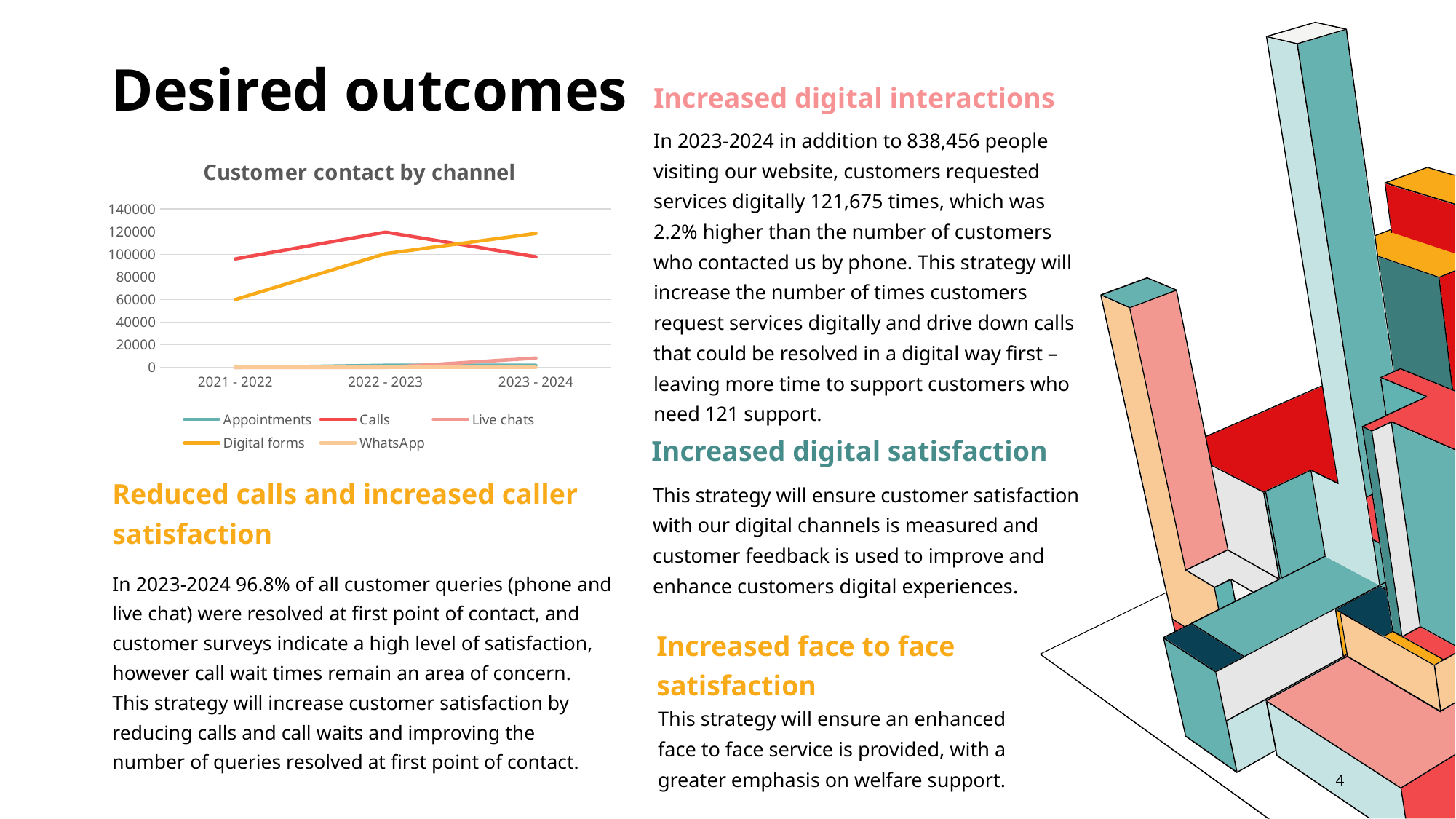
Is the value for Calls in 2023 - 2024 greater or less than 80000? greater What is the title of the chart? Customer contact by channel In 2023 - 2024, which is larger: Digital forms or Calls? Digital forms Is the value for Digital forms in 2021 - 2022 greater or less than 80000? less Which series has the highest value in 2022 - 2023? Calls In 2021 - 2022, which is larger: Calls or Digital forms? Calls In which period does the Calls series reach its highest value? 2022 - 2023 How many series does the chart's legend list? 5 What kind of chart is shown on the slide? line chart Is the value for Calls in 2022 - 2023 greater or less than 100000? greater Do the values for Digital forms rise or fall from 2021 - 2022 to 2023 - 2024? rise How many time periods are shown on the x axis of the chart? 3